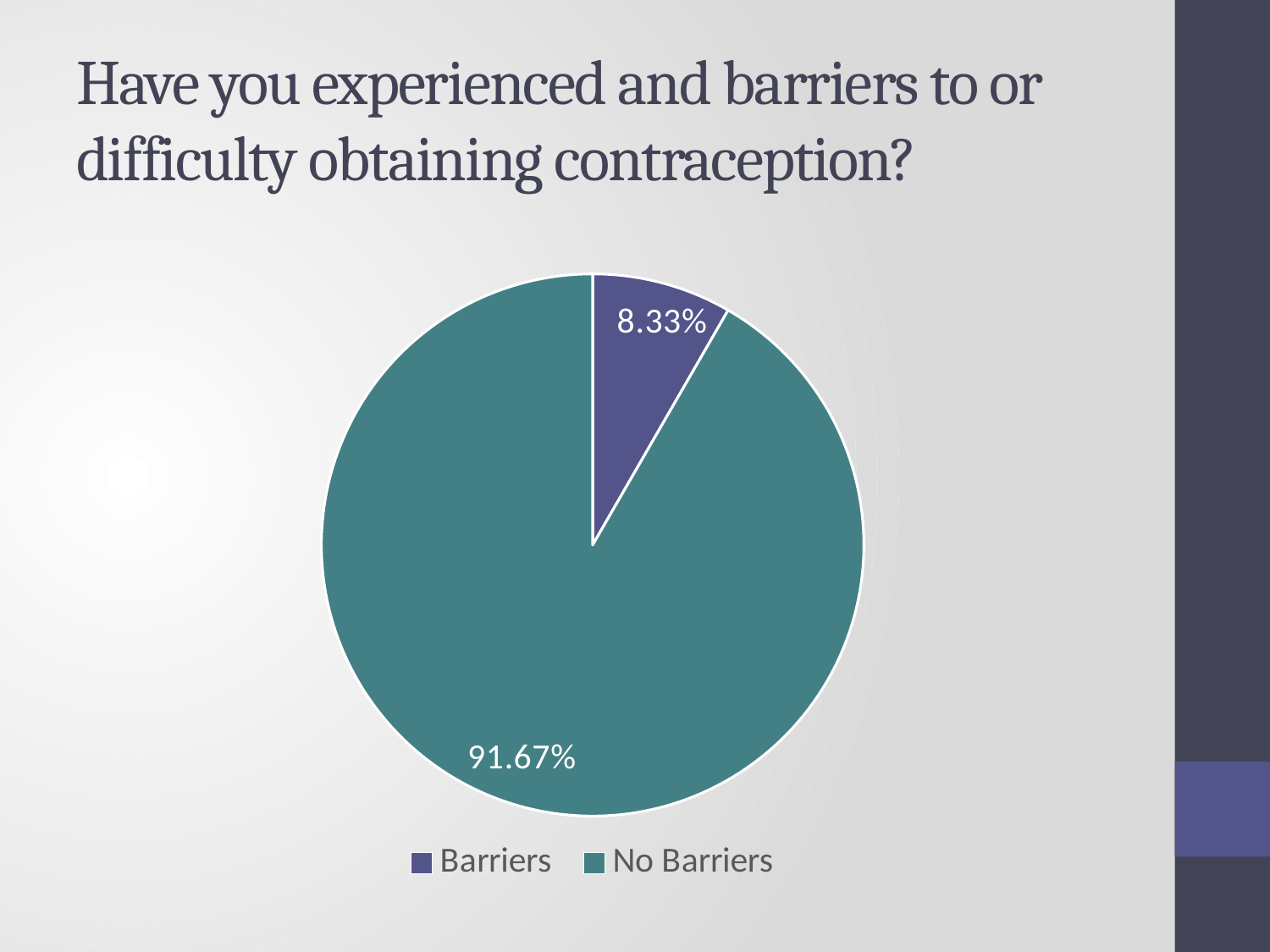
What is the difference in percentage points between the No Barriers and Barriers slices? 83.34 How many entries does the legend list? 2 How many slices does the pie chart have? 2 What percentage of respondents reported Barriers? 8.33% Which category has the largest share of the pie? No Barriers What type of chart is shown on the slide? pie chart Which category has the smallest share of the pie? Barriers What is the title of the slide containing the pie chart? Have you experienced and barriers to or difficulty obtaining contraception? What percentage of respondents reported No Barriers? 91.67% What colour is the No Barriers slice? teal What share of the pie does the Barriers slice represent? 8.33% Which is larger, the share for Barriers or the share for No Barriers? No Barriers